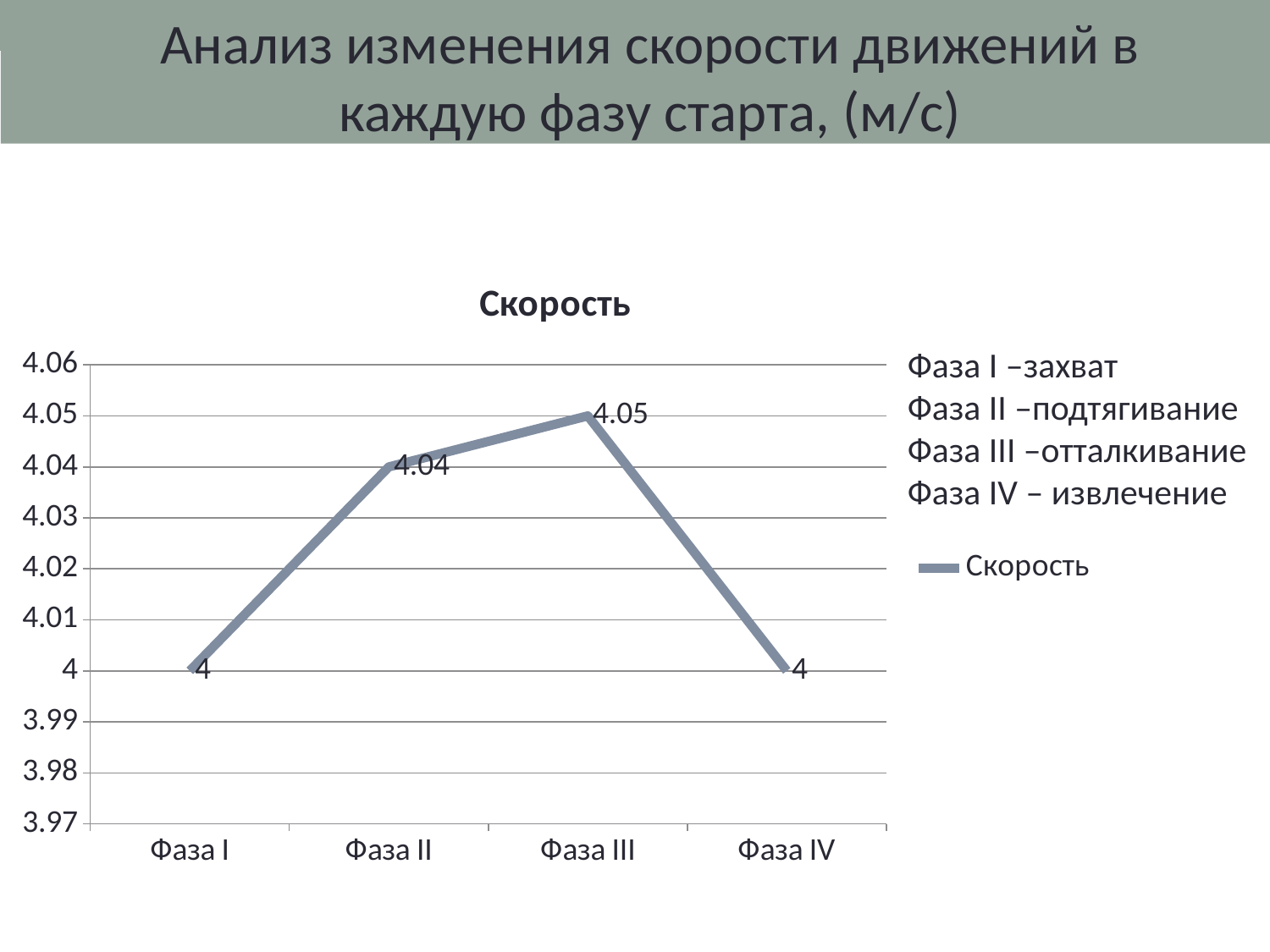
What is the value for Фаза II? 4.04 How many phases are plotted on the x axis? 4 What kind of chart is shown? line chart Is the value for Фаза III greater or less than 4.02? greater Which is larger, the value for Фаза II or the value for Фаза IV? Фаза II What is the difference between the values for Фаза II and Фаза I? 0.04 What is the title of the chart? Скорость What is the value for Фаза III? 4.05 Which phase has the highest value? Фаза III What is the difference between the values for Фаза III and Фаза II? 0.01 How many series does the legend list? 1 What is the value for Фаза I? 4